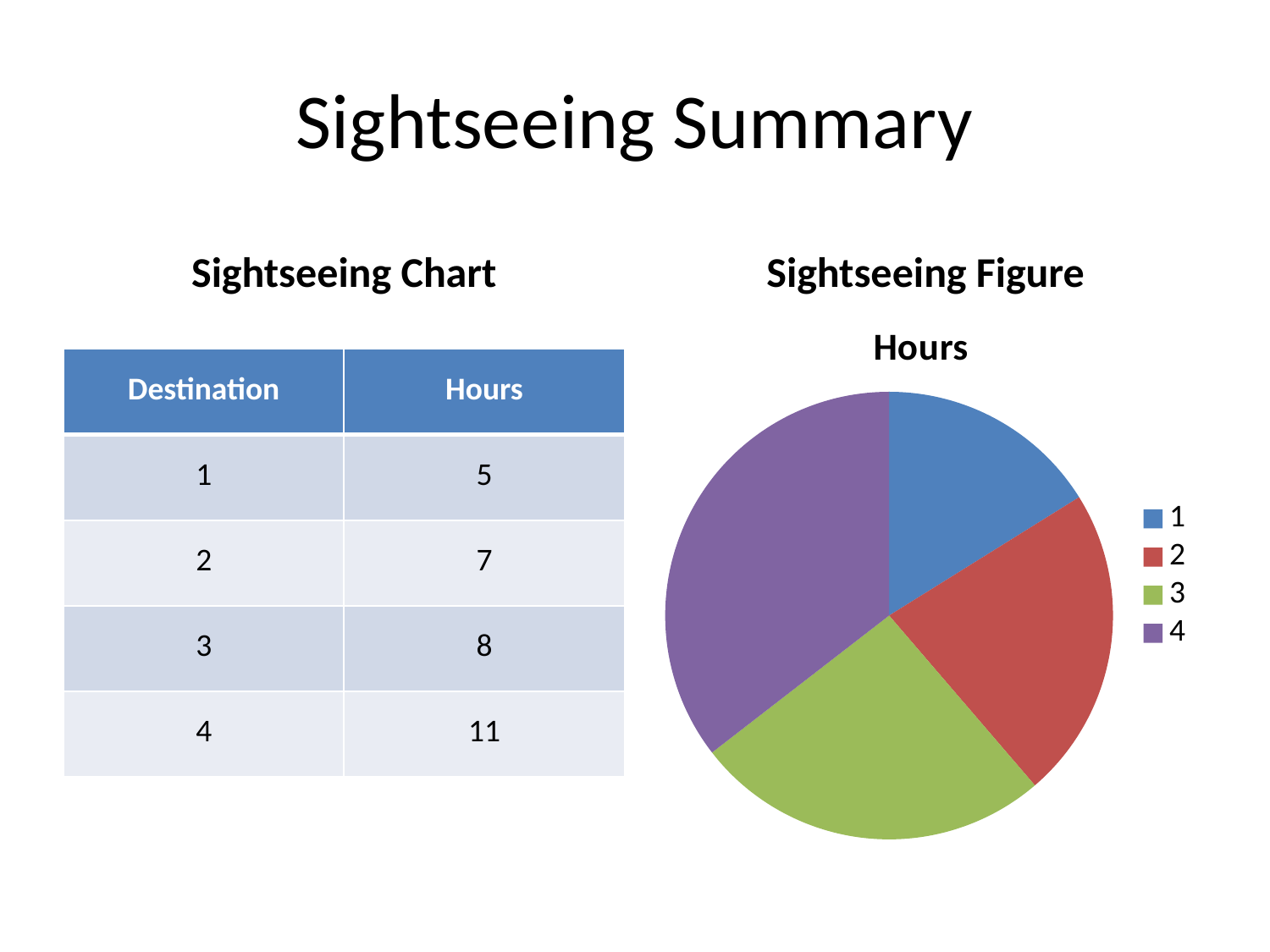
Is the slice for destination 1 larger or smaller than the slice for destination 3? smaller How many hours are shown for destination 4? 11 Which destination has the smallest slice in the pie chart? 1 Which destination has the largest slice in the pie chart? 4 How many slices does the pie chart have? 4 What kind of chart is shown under the Sightseeing Figure heading? pie chart What colour is the slice for destination 3 in the pie chart? green What is the total number of hours across all four destinations? 31 How many hours are shown for destination 2? 7 What is the difference in hours between destination 4 and destination 1? 6 What is the title of the pie chart? Hours Is the slice for destination 4 larger or smaller than the slice for destination 2? larger